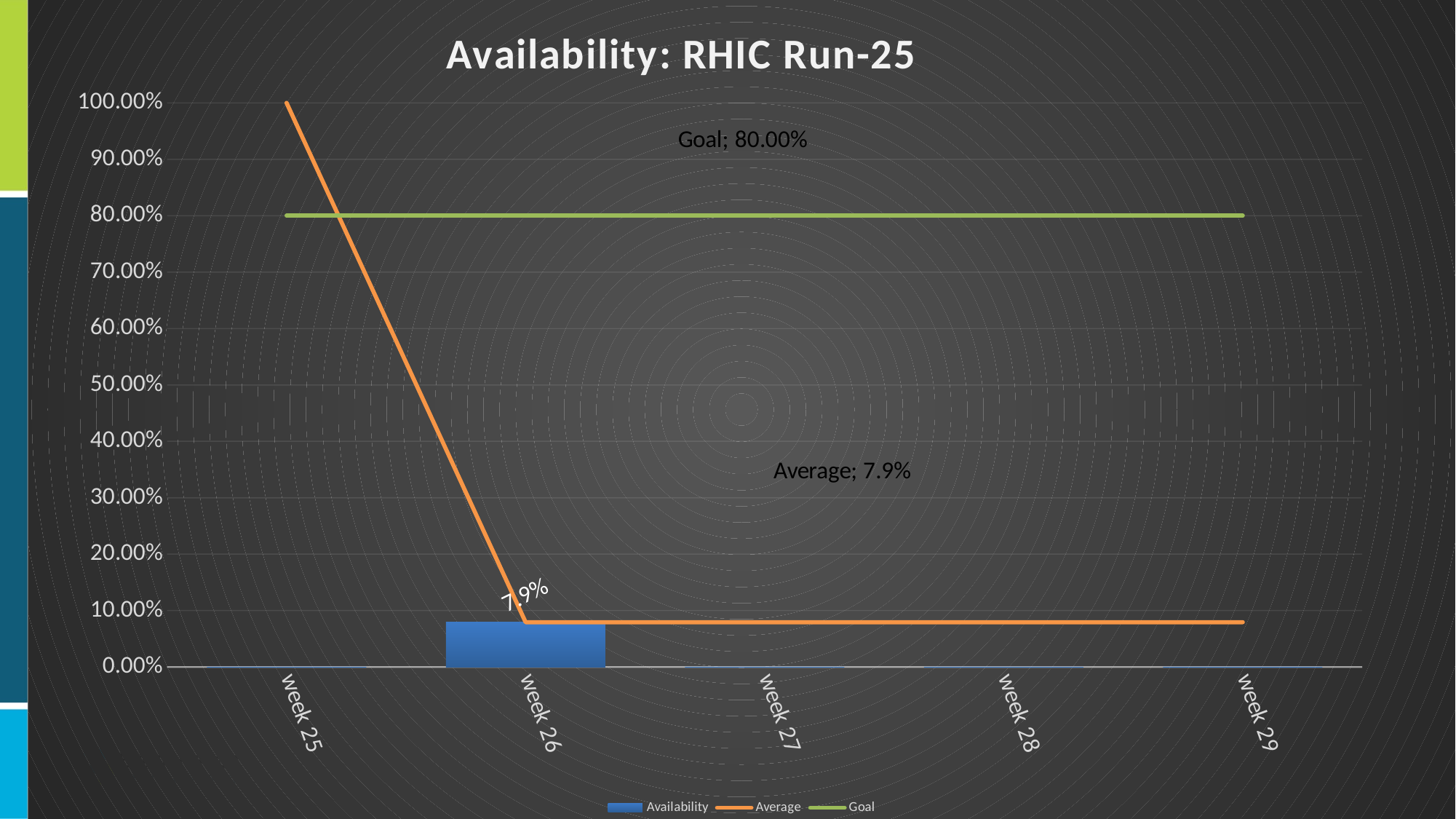
What kind of chart is this? Bar and line chart Which is larger, the Goal value or the Average value? Goal Does the Average line rise or fall from week 25 to week 26? fall Is the Average line at week 25 greater or less than 90.00%? greater What is the Availability value shown for week 26? 7.9% What is the difference between the Goal value (80.00%) and the Average value (7.9%)? 72.1% What value is labelled for the Average line? 7.9% What value is labelled for the Goal line? 80.00% How many weeks are shown on the x axis? 5 Which week has the highest Availability bar? week 26 How many series does the legend list? 3 What is the title of the chart? Availability: RHIC Run-25